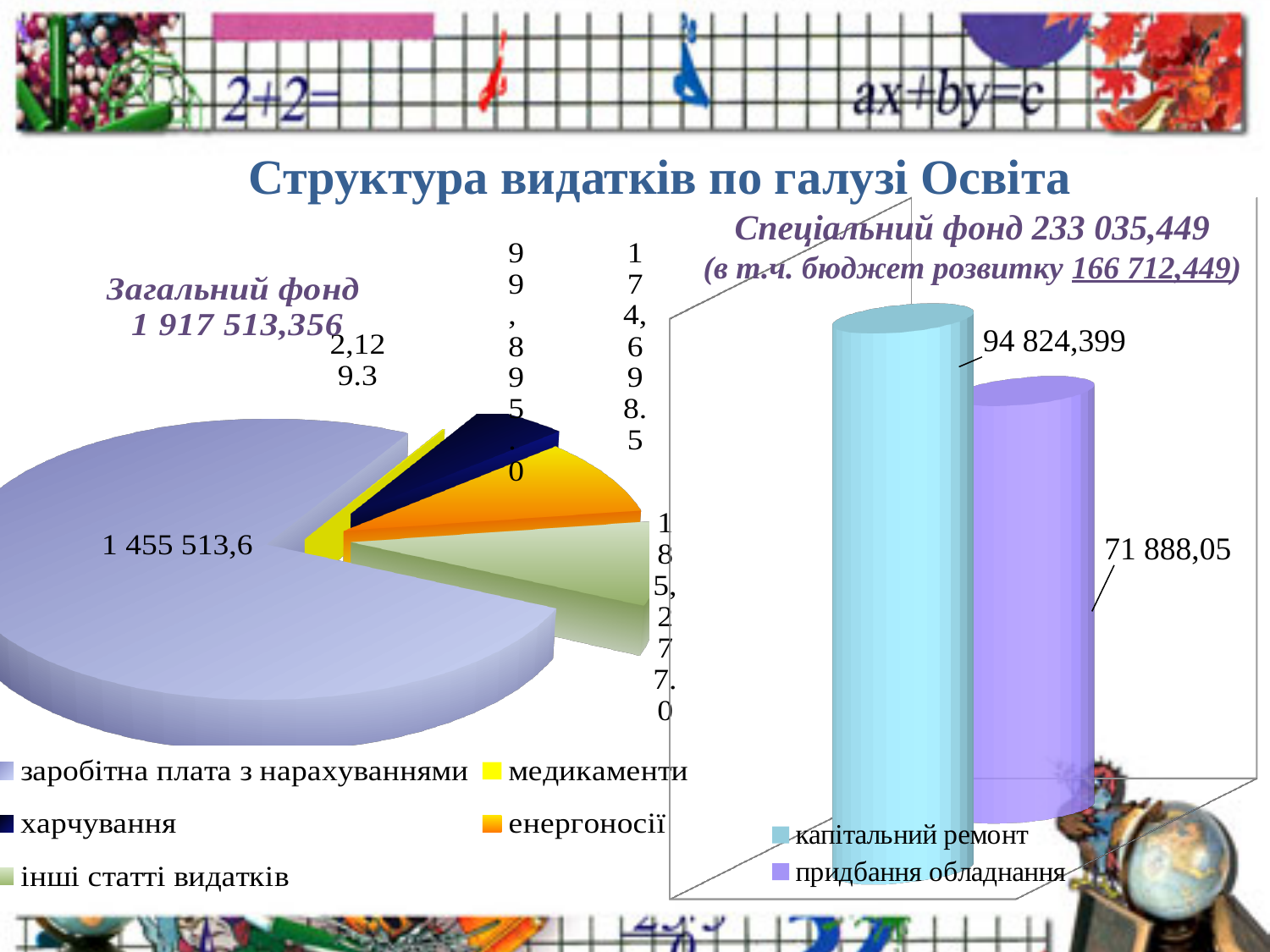
How many series does the legend of the right-hand chart (Спеціальний фонд) list? 2 In the right-hand chart (Спеціальний фонд), which is larger: капітальний ремонт or придбання обладнання? капітальний ремонт What kind of chart is the chart on the left of the slide (Загальний фонд)? pie chart In the right-hand chart (Спеціальний фонд), what is the value for капітальний ремонт? 94 824,399 In the right-hand chart (Спеціальний фонд), what is the difference between капітальний ремонт and придбання обладнання? 22 936,349 In the left-hand pie chart (Загальний фонд), what is the value for заробітна плата з нарахуваннями? 1 455 513,6 What kind of chart is the chart on the right of the slide (Спеціальний фонд)? bar chart What total amount is given for Загальний фонд in the heading above the pie chart? 1 917 513,356 In the left-hand pie chart (Загальний фонд), which category has the smallest slice? медикаменти In the right-hand chart (Спеціальний фонд), what is the value for придбання обладнання? 71 888,05 In the left-hand pie chart (Загальний фонд), which category has the largest slice? заробітна плата з нарахуваннями How many categories does the legend of the left-hand pie chart (Загальний фонд) list? 5